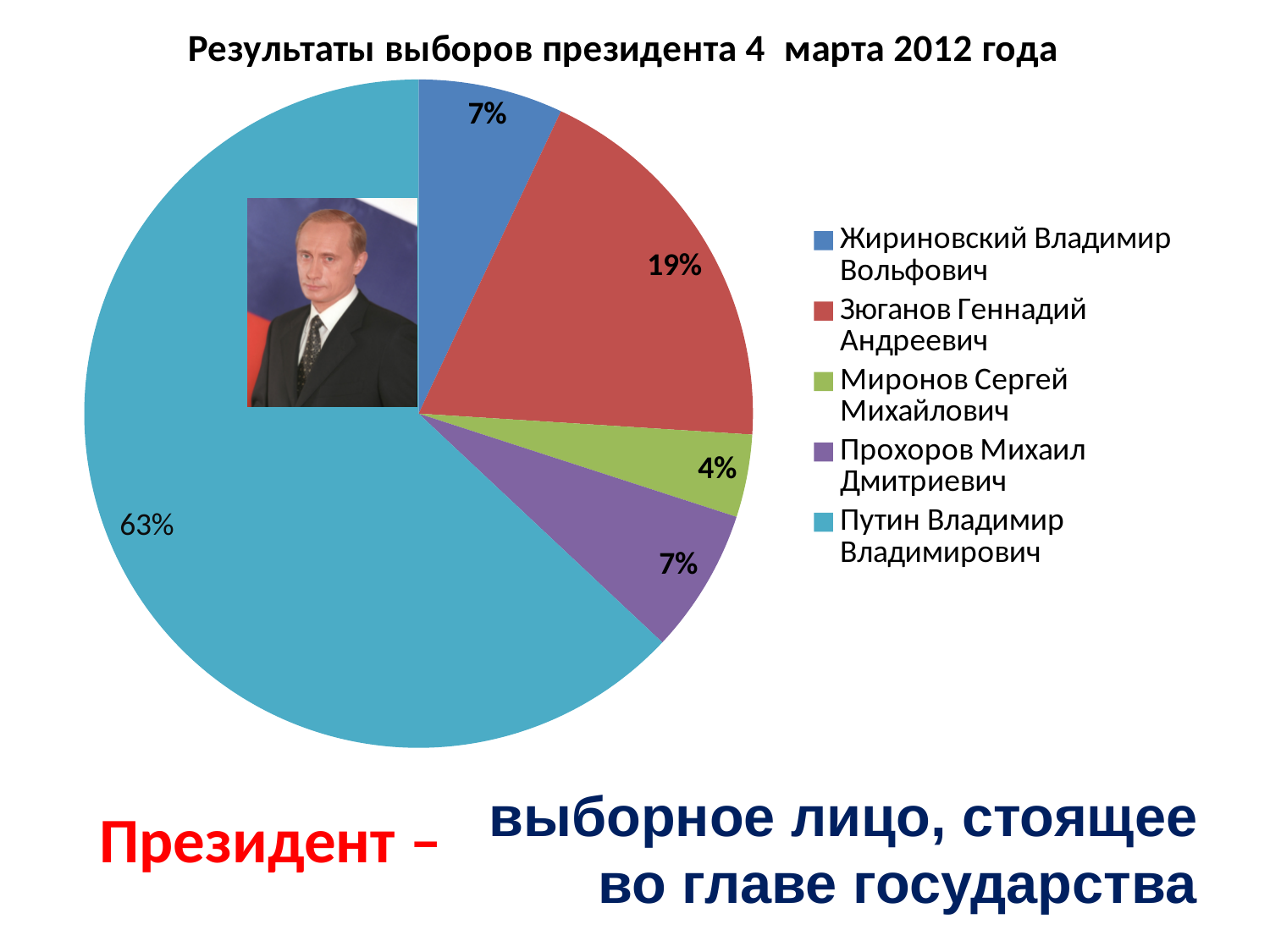
What colour is the slice for Зюганов Геннадий Андреевич? red What share of the pie does Путин Владимир Владимирович have? 63% What share of the pie does Прохоров Михаил Дмитриевич have? 7% Which candidate has the smallest slice of the pie? Миронов Сергей Михайлович What is the title of the chart? Результаты выборов президента 4 марта 2012 года What kind of chart is shown on the slide? pie chart What is the difference between the shares of Путин Владимир Владимирович and Зюганов Геннадий Андреевич? 44% What share of the pie does Зюганов Геннадий Андреевич have? 19% Which candidate has the largest slice of the pie? Путин Владимир Владимирович Who has the larger share, Зюганов Геннадий Андреевич or Жириновский Владимир Вольфович? Зюганов Геннадий Андреевич What share of the pie does Миронов Сергей Михайлович have? 4% How many candidates are listed in the legend? 5